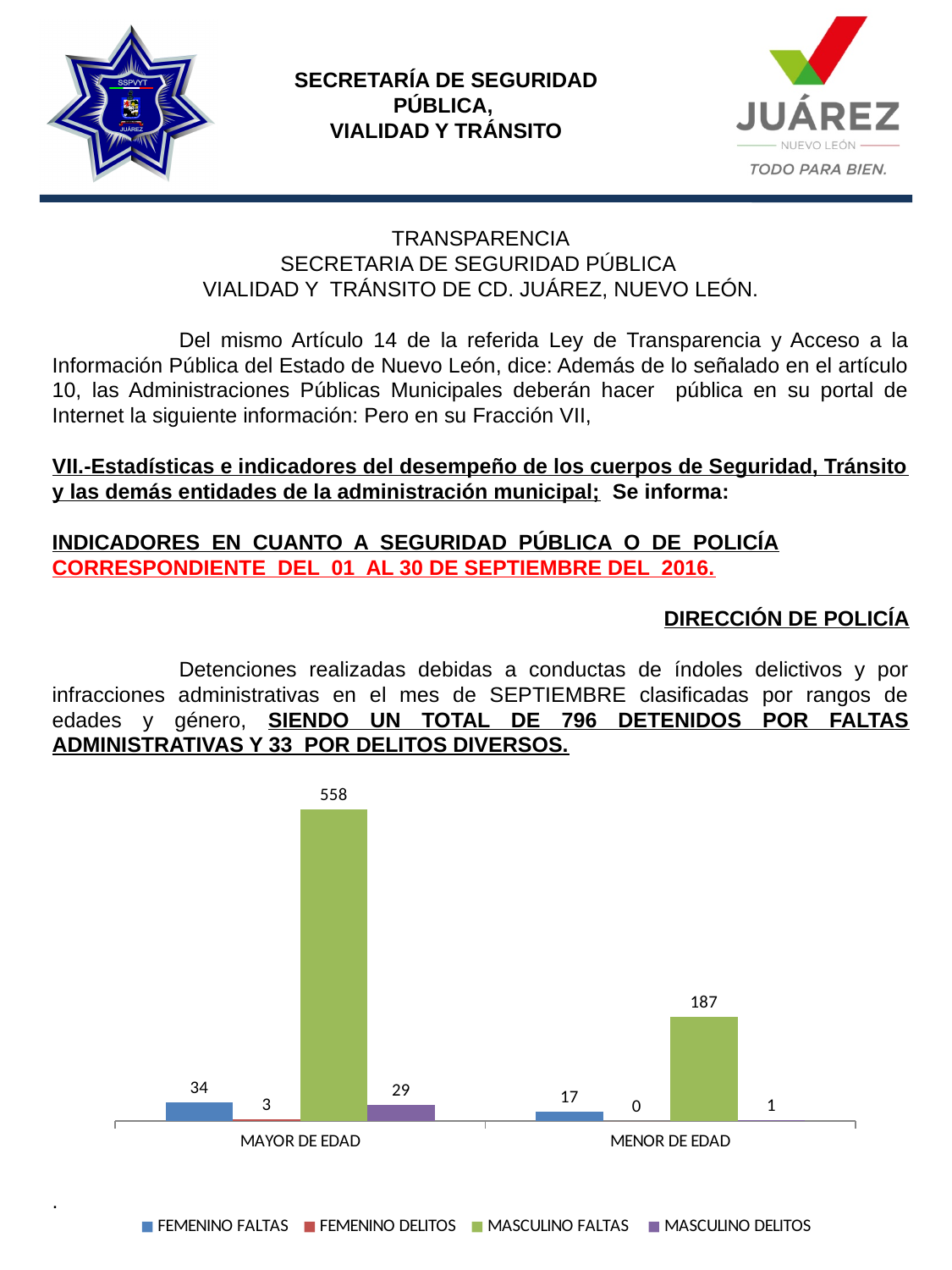
What is the value for MASCULINO DELITOS in the MAYOR DE EDAD category? 29 How many series does the legend list? 4 Which is larger: FEMENINO FALTAS for MAYOR DE EDAD or MASCULINO DELITOS for MAYOR DE EDAD? FEMENINO FALTAS for MAYOR DE EDAD What is the value for FEMENINO DELITOS in the MENOR DE EDAD category? 0 How many categories are shown on the x axis? 2 What is the difference between MASCULINO FALTAS for MAYOR DE EDAD and MASCULINO FALTAS for MENOR DE EDAD? 371 What is the value for FEMENINO FALTAS in the MENOR DE EDAD category? 17 What kind of chart is shown on the slide? bar chart What is the value for MASCULINO FALTAS in the MAYOR DE EDAD category? 558 Which series has the highest value in the MENOR DE EDAD category? MASCULINO FALTAS What colour are the MASCULINO FALTAS bars? green Which series has the lowest value in the MAYOR DE EDAD category? FEMENINO DELITOS